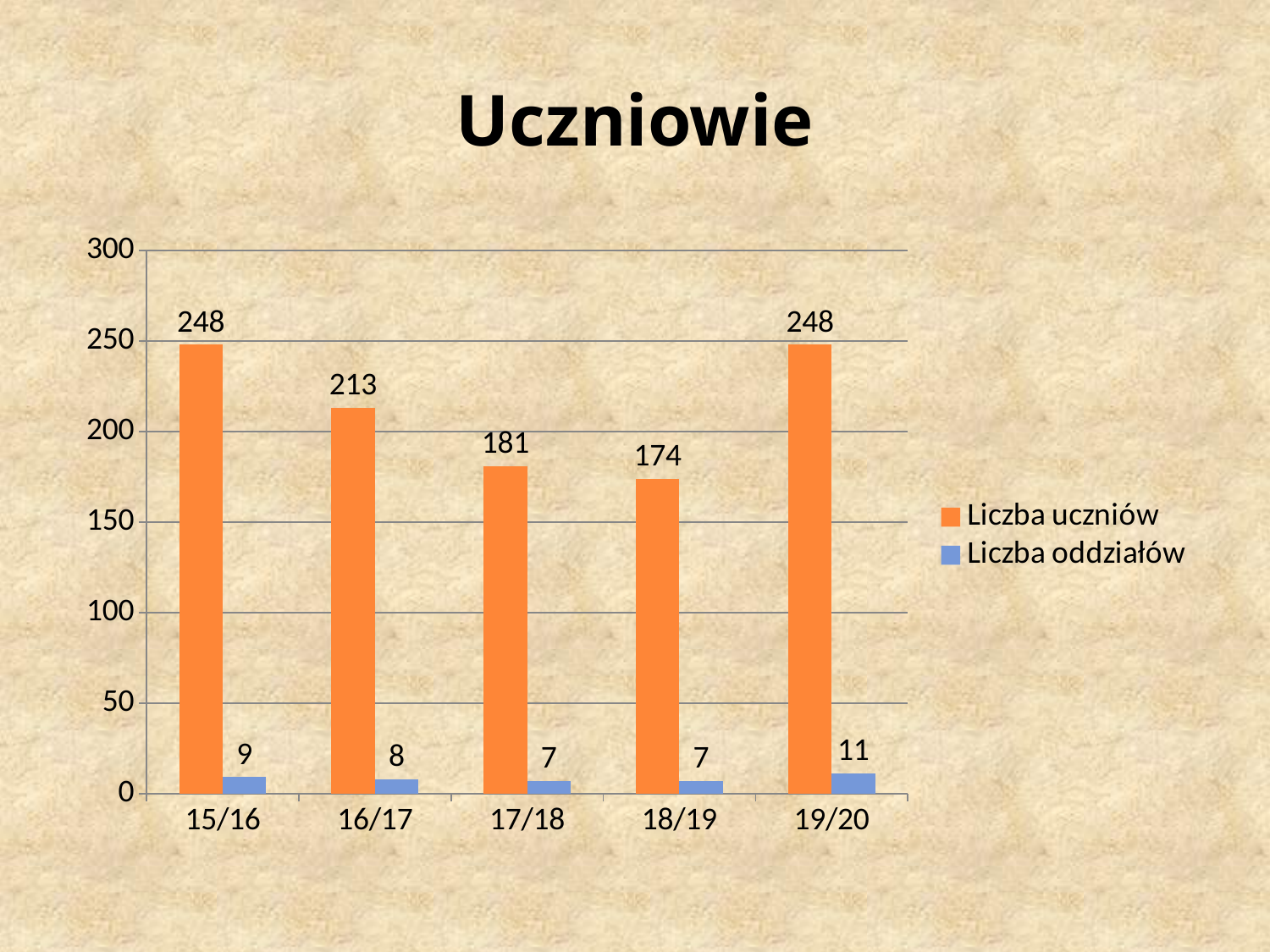
What is the difference between Liczba uczniów in 15/16 and 17/18? 67 How many categories are shown on the x axis? 5 What is the value of Liczba oddziałów for 19/20? 11 What is the value of Liczba uczniów for 16/17? 213 Which category has the lowest value for Liczba uczniów? 18/19 What is the value of Liczba uczniów for 18/19? 174 Is the value of Liczba uczniów for 17/18 greater or less than 200? less Which is larger, Liczba uczniów for 16/17 or for 18/19? 16/17 What is the title of the chart? Uczniowie How many series does the legend list? 2 Which category has the highest value for Liczba oddziałów? 19/20 What kind of chart is shown on the slide? bar chart